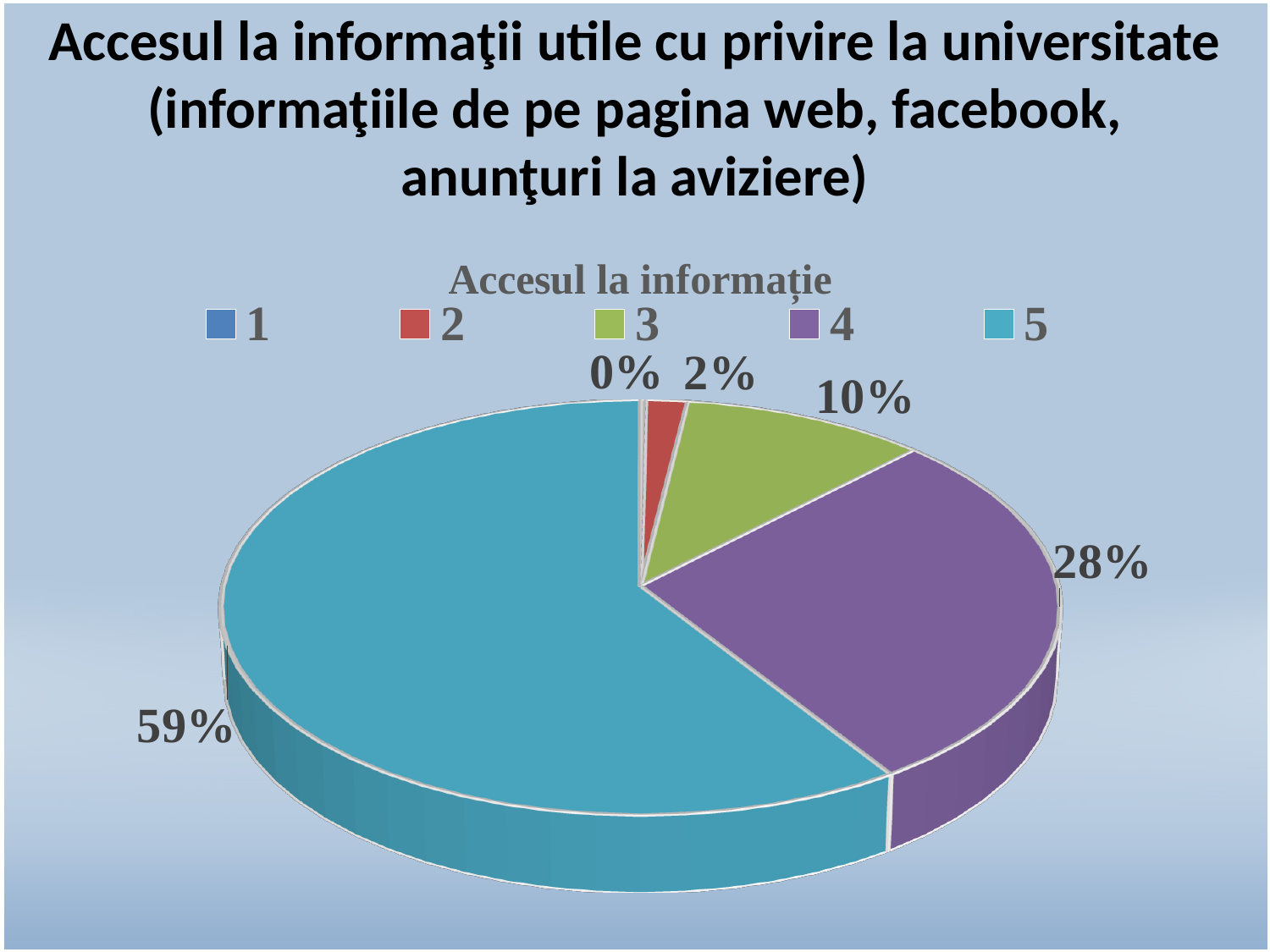
What is the value for category 1? 0% What is the value for category 2? 2% What share of the pie does category 4 have? 28% Which category has the smallest share of the pie? 1 What is the value for category 3? 10% What kind of chart is shown on the slide? pie chart How many categories does the legend list? 5 Which is larger, the share for category 3 or the share for category 4? 4 What is the difference between the shares of category 5 and category 4? 31% What share of the pie does category 5 have? 59% What is the chart title shown above the legend? Accesul la informație Which category has the largest share of the pie? 5